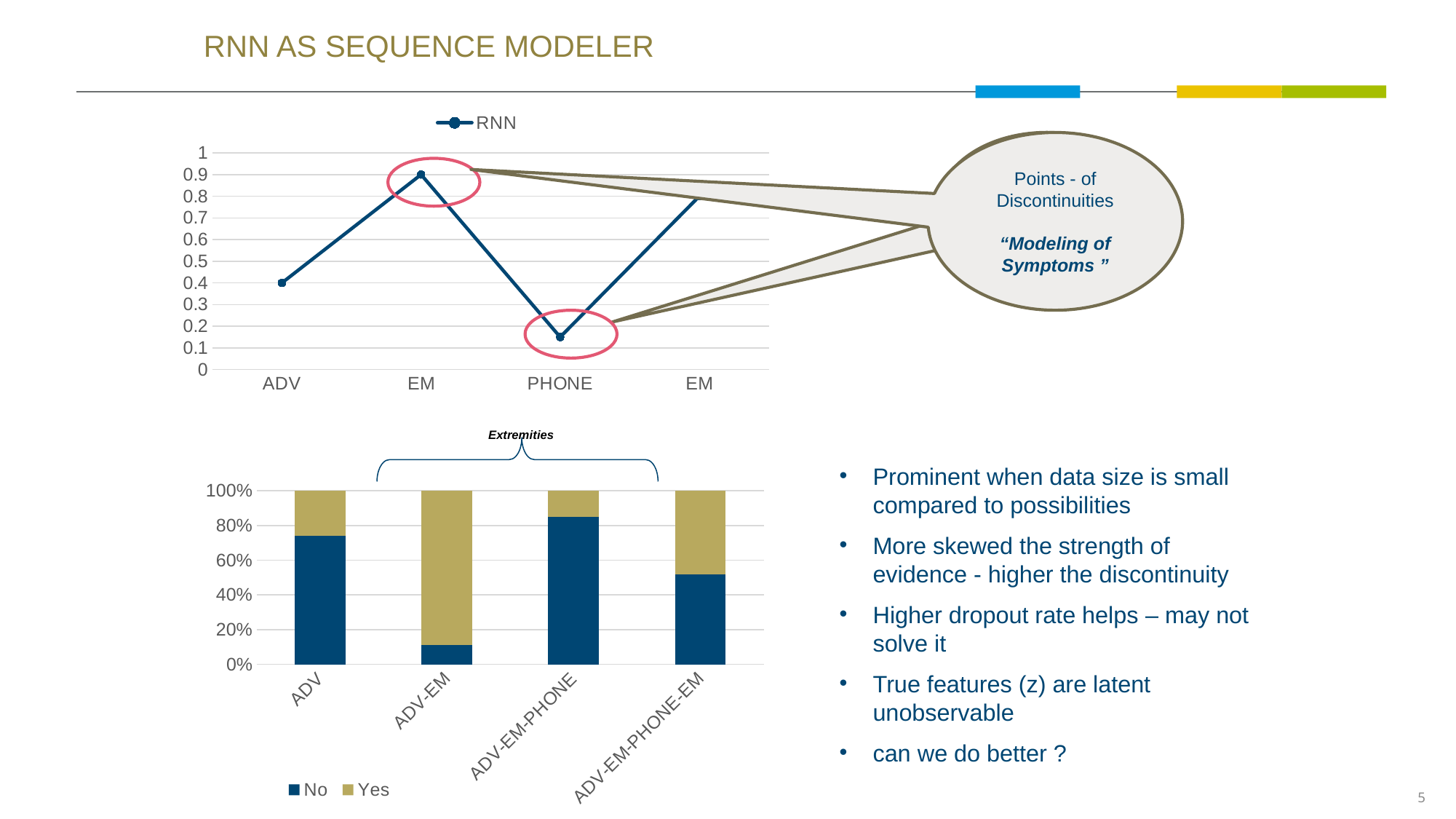
In the top line chart, which category has the lowest RNN value? PHONE In the top line chart, which category has the highest RNN value? EM (second category) In the top line chart, how many data points are plotted? 4 In the top line chart, is the RNN value for ADV greater or less than 0.6? less What type of chart is the top chart on the slide? line chart In the bottom stacked bar chart, how many categories are shown on the x axis? 4 What type of chart is the bottom chart on the slide? bar chart In the top line chart, is the RNN value for PHONE greater or less than 0.3? less In the bottom stacked bar chart, which category has the smallest 'No' share? ADV-EM In the bottom stacked bar chart, how many series does the legend list? 2 In the bottom stacked bar chart, is the 'No' share for ADV-EM-PHONE greater or less than 80%? greater In the top line chart, which series name is shown in the legend? RNN